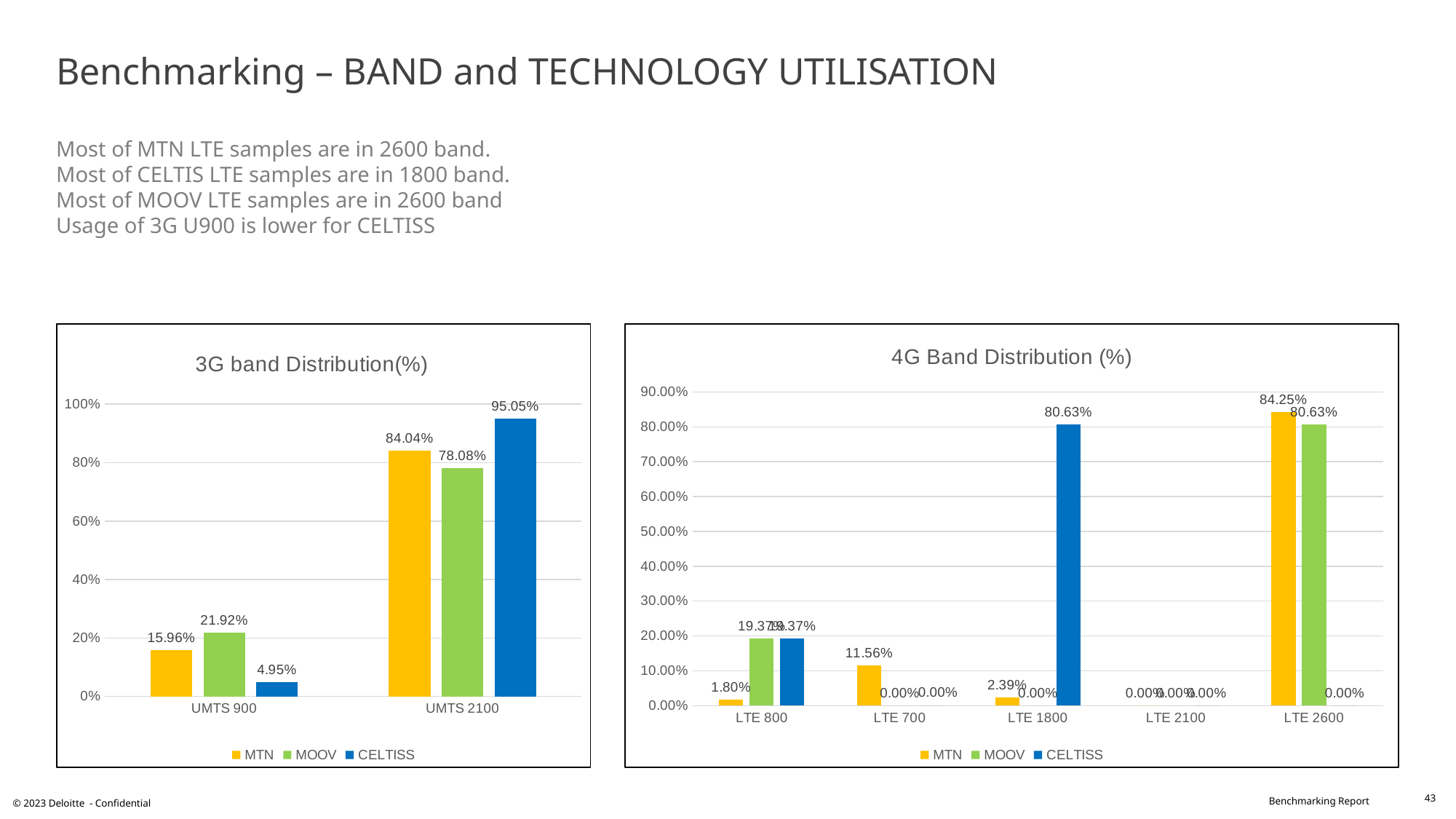
In the 3G band Distribution(%) chart, which series has the lowest value in UMTS 900? CELTISS In the 3G band Distribution(%) chart, what is the value for CELTISS in UMTS 2100? 95.05% What kind of chart is the 4G Band Distribution (%) chart? Bar chart In the 3G band Distribution(%) chart, how many series does the legend list? 3 In the 4G Band Distribution (%) chart, how many band categories are shown on the x axis? 5 In the 4G Band Distribution (%) chart, which is larger: MTN in LTE 800 or MTN in LTE 1800? MTN in LTE 1800 In the 4G Band Distribution (%) chart, which series has the highest value in LTE 2600? MTN In the 3G band Distribution(%) chart, what is the difference between MTN and MOOV in UMTS 2100? 5.96% In the 4G Band Distribution (%) chart, what is the value for CELTISS in LTE 1800? 80.63% In the 3G band Distribution(%) chart, what is the value for MOOV in UMTS 900? 21.92% In the 4G Band Distribution (%) chart, is the value for MTN in LTE 2600 greater or less than 80.00%? greater In the 4G Band Distribution (%) chart, what is the value for MTN in LTE 700? 11.56%